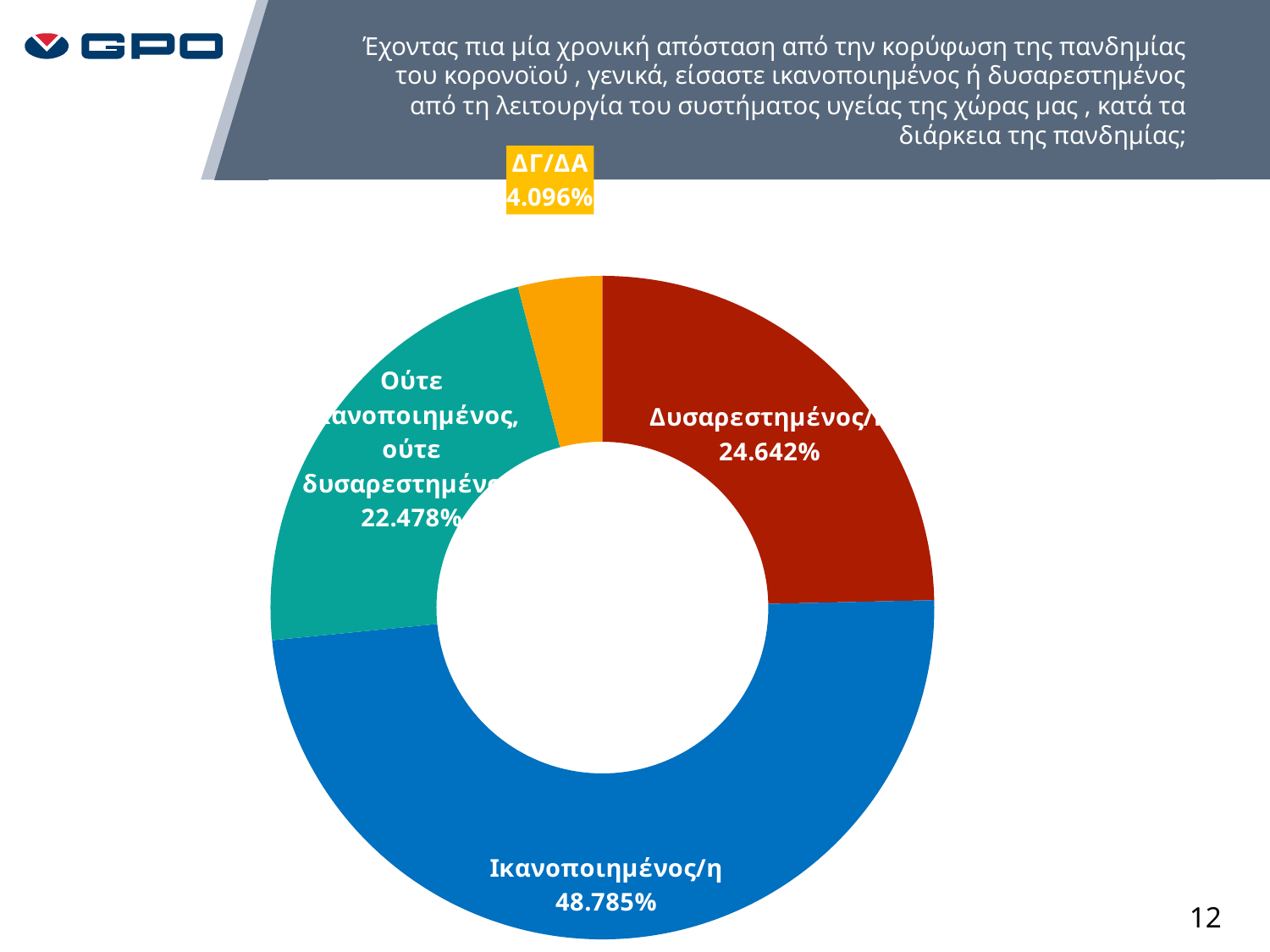
What percentage of respondents answered Δυσαρεστημένος/η? 24.642% What percentage of respondents answered Ούτε ικανοποιημένος, ούτε δυσαρεστημένος? 22.478% What percentage of respondents answered ΔΓ/ΔΑ? 4.096% What is the difference in percentage points between Ικανοποιημένος/η and Δυσαρεστημένος/η? 24.143% Which response category has the largest share? Ικανοποιημένος/η Which is larger, the share for Δυσαρεστημένος/η or the share for ΔΓ/ΔΑ? Δυσαρεστημένος/η What colour is the slice for Ικανοποιημένος/η? Blue How many response categories are shown in the chart? 4 What percentage of respondents answered Ικανοποιημένος/η? 48.785% What is the difference in percentage points between Δυσαρεστημένος/η and Ούτε ικανοποιημένος, ούτε δυσαρεστημένος? 2.164% Which response category has the smallest share? ΔΓ/ΔΑ What kind of chart is shown on the slide? Doughnut (pie) chart